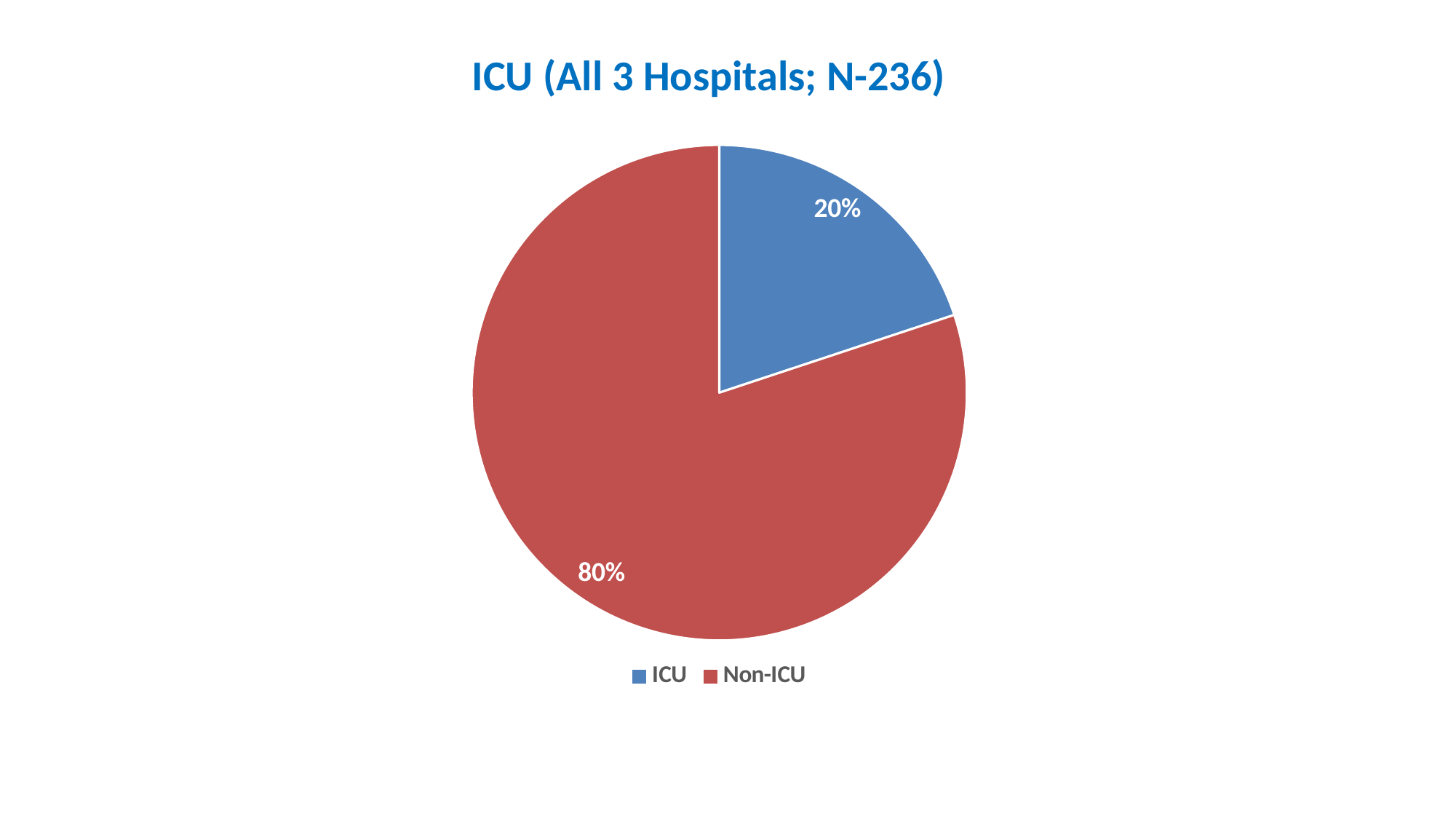
Which slice is the smallest? ICU Which slice is the largest? Non-ICU What colour is the Non-ICU slice? red What share of the pie does the ICU slice represent? 20% What is the difference in percentage points between the Non-ICU and ICU slices? 60 How many entries does the legend list? 2 How many slices does the pie chart have? 2 Which is larger, the ICU slice or the Non-ICU slice? Non-ICU What is the title of the chart? ICU (All 3 Hospitals; N-236) What share of the pie does the Non-ICU slice represent? 80% What kind of chart is shown on the slide? pie chart